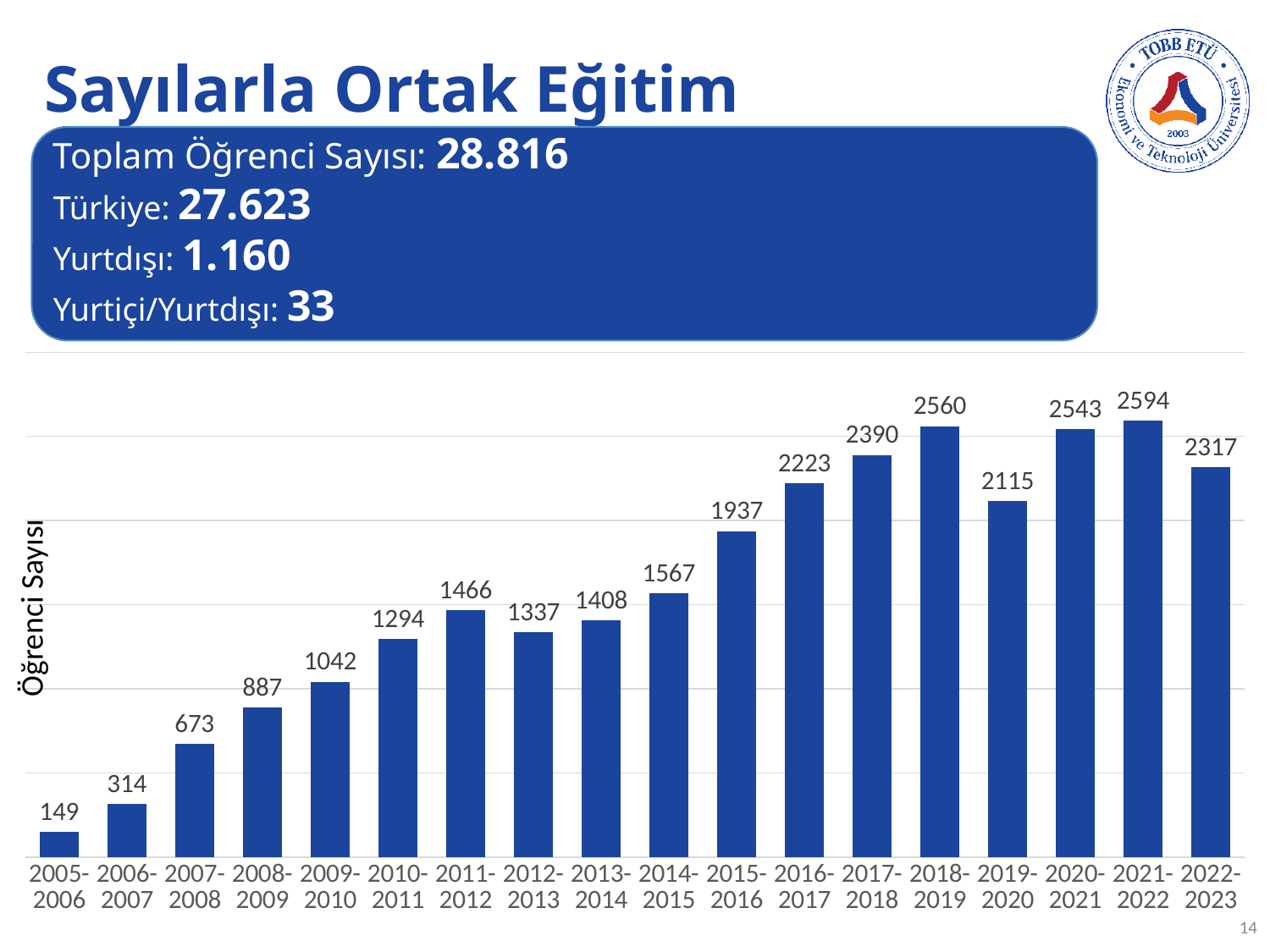
Which is larger, the value for 2011-2012 or the value for 2012-2013? 2011-2012 What is the value for 2005-2006? 149 What is the difference between the values for 2018-2019 and 2019-2020? 445 Do the values generally rise or fall from 2005-2006 to 2021-2022? Rise What is the difference between the values for 2021-2022 and 2022-2023? 277 Which academic year has the lowest value? 2005-2006 Which academic year has the highest value? 2021-2022 What is the value for 2022-2023? 2317 How many academic years are shown on the x axis? 18 What kind of chart is shown on the slide? Bar chart What is the label on the y axis of the chart? Öğrenci Sayısı What is the value for 2015-2016? 1937